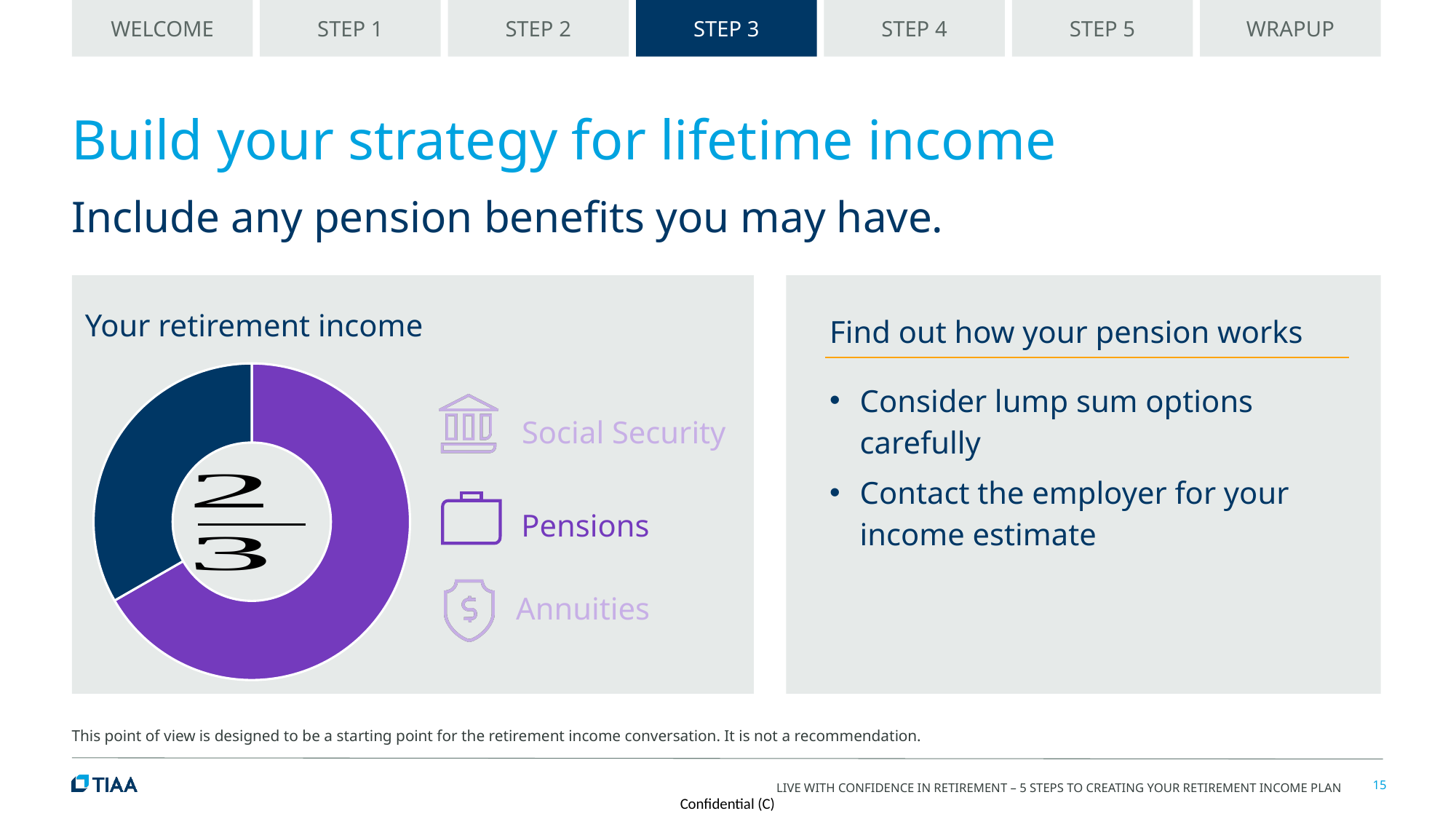
Is the dark navy segment of the 'Your retirement income' chart greater or less than half of the chart? less Which segment of the 'Your retirement income' chart is larger, the purple one or the dark navy one? purple What kind of chart is shown in the 'Your retirement income' panel? doughnut chart Which legend item next to the 'Your retirement income' chart is shown in the same purple colour as the large segment? Pensions What fraction is printed in the center of the 'Your retirement income' chart? 2/3 What is the title of the chart panel on the left of the slide? Your retirement income Is the purple segment of the 'Your retirement income' chart greater or less than half of the chart? greater How many segments does the 'Your retirement income' donut chart have? 2 How many items are listed in the legend next to the 'Your retirement income' chart? 3